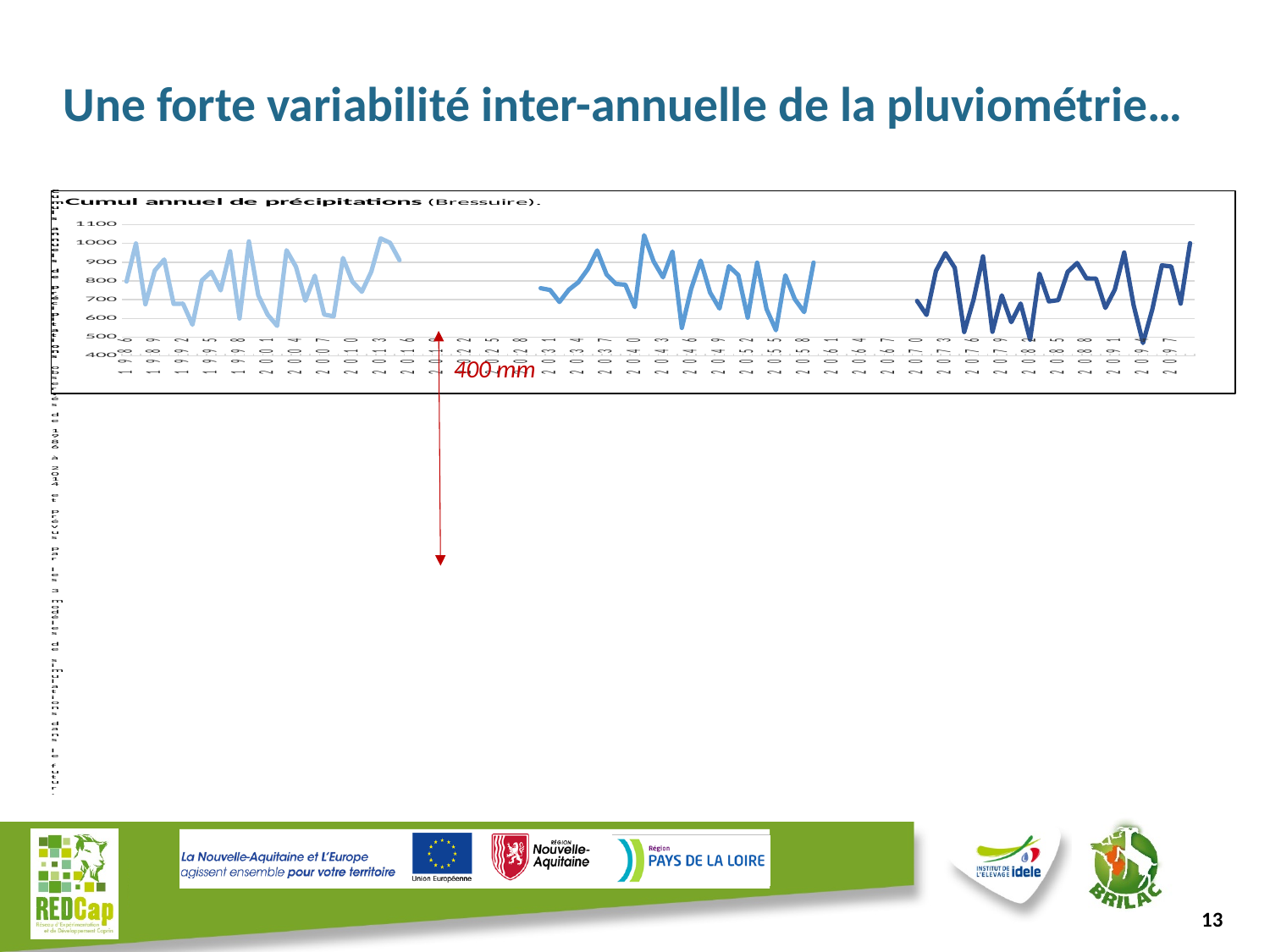
Is the lowest point plotted on the chart greater or less than 600? less What value is written in red next to the arrow below the chart? 400 mm What is the first year labelled on the chart's horizontal axis? 1986 What is the lowest value shown on the chart's vertical axis? 400 What kind of chart is shown on the slide? line chart Is the highest point plotted on the chart greater or less than 1000? greater What is the highest value shown on the chart's vertical axis? 1100 What is the title of the chart? Cumul annuel de précipitations (Bressuire). What is the last year labelled on the chart's horizontal axis? 2097